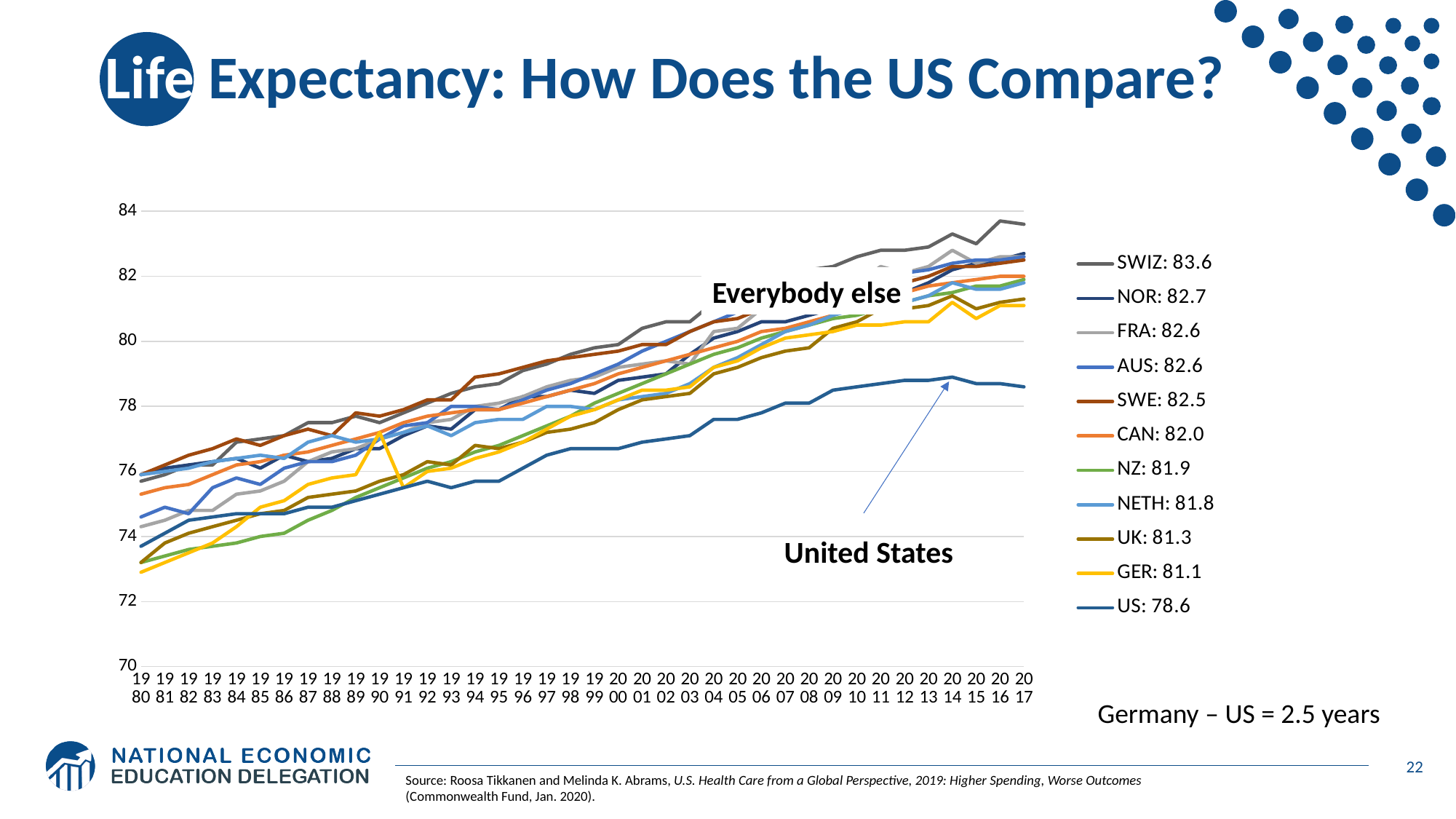
What is the difference between the SWIZ value and the US value shown in the legend? 5.0 What life expectancy value is shown for the UK in the legend? 81.3 How many years are shown along the x axis? 38 Which has the larger legend value, CAN or NZ? CAN Over the period from 1980 to 2017, do the life expectancy lines generally rise or fall? rise Which country has the highest life expectancy value shown in the legend? SWIZ: 83.6 How many countries (series) does the legend list? 11 Which country has the lowest life expectancy value shown in the legend? US: 78.6 According to the slide, what is the gap between Germany and the US in years? 2.5 years What kind of chart is shown on the slide? line chart What life expectancy value is shown for NOR in the legend? 82.7 Is the value for the United States in 2000 greater or less than 78? less